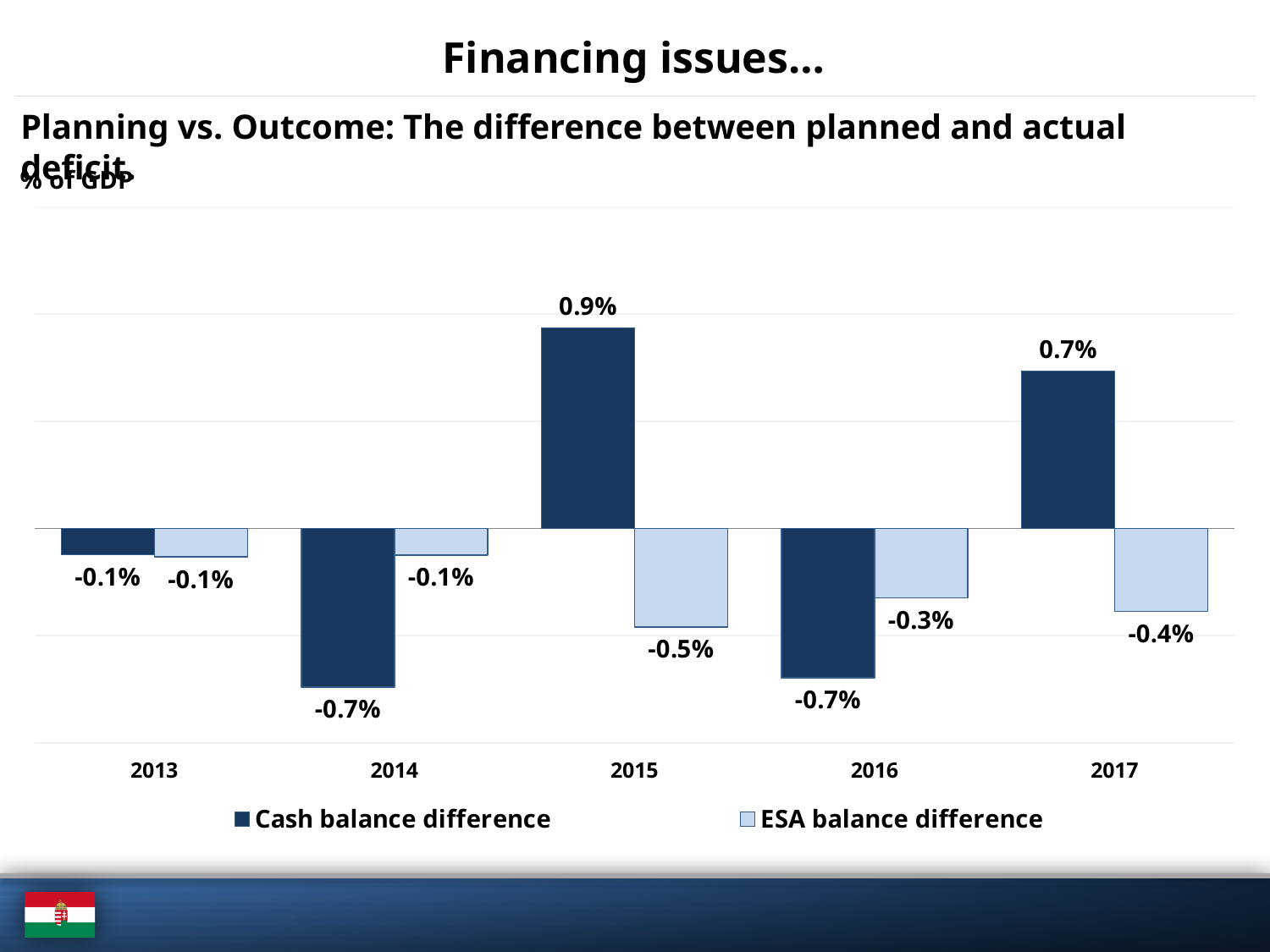
What kind of chart is shown on the slide? Bar chart What is the ESA balance difference for 2017? -0.4% Which is larger in 2017, the Cash balance difference or the ESA balance difference? Cash balance difference In which year is the Cash balance difference highest? 2015 What unit is indicated above the chart? % of GDP What is the Cash balance difference for 2014? -0.7% In which year is the ESA balance difference lowest? 2015 How many years are shown on the x axis? 5 How many series does the legend list? 2 What is the Cash balance difference for 2015? 0.9% What is the difference between the Cash balance difference and the ESA balance difference in 2015? 1.4 percentage points What is the ESA balance difference for 2016? -0.3%